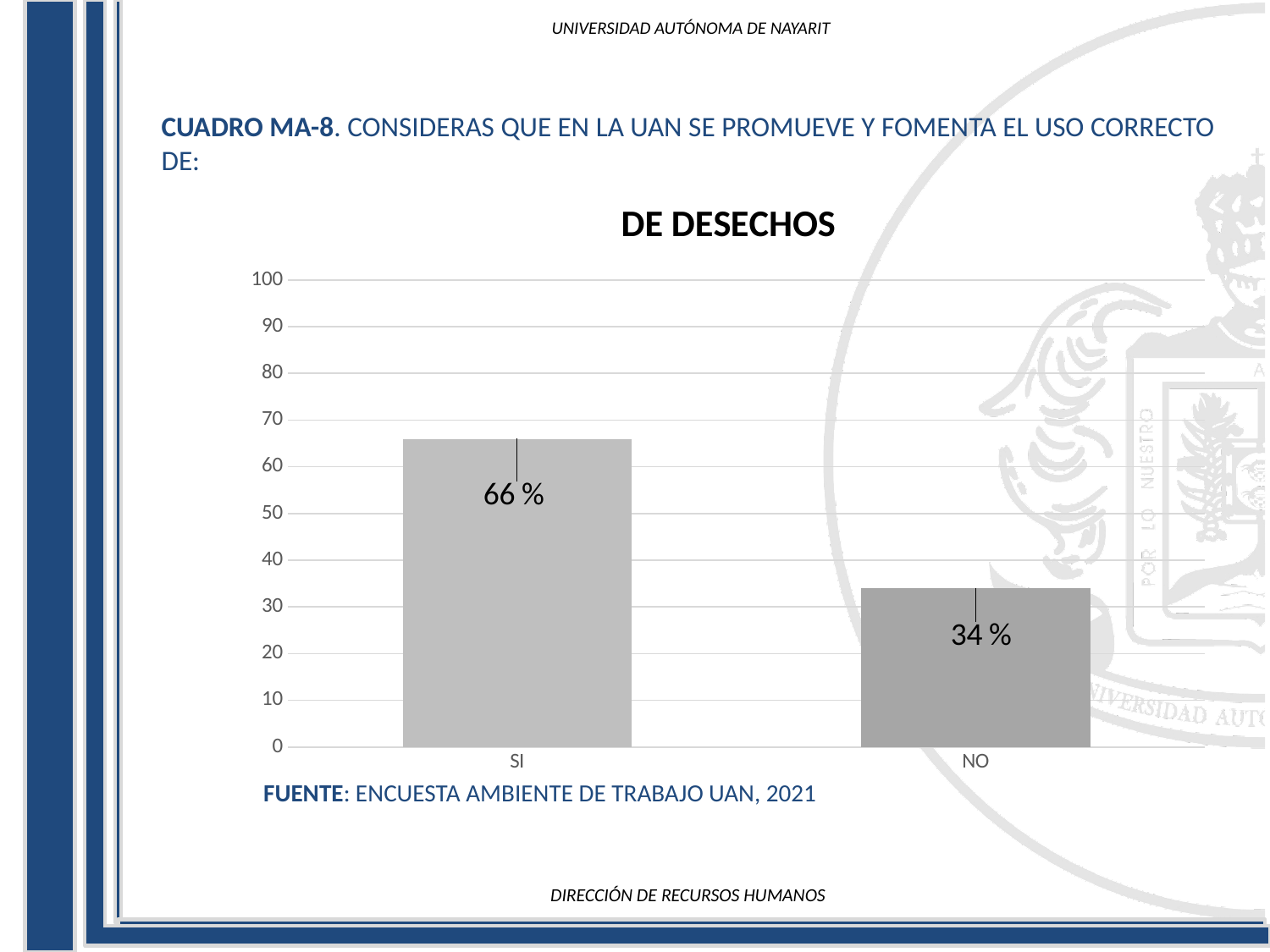
What is the value for SI? 66 % What is the title of the chart? DE DESECHOS How many categories are shown on the x axis? 2 Which is larger, the value for SI or the value for NO? SI Which category has the lowest value? NO What kind of chart is shown? bar chart What is the value for NO? 34 % What is the difference between the values for SI and NO? 32 % Is the value for SI greater or less than 60? greater Is the value for NO greater or less than 40? less Which category has the highest value? SI What is the maximum value shown on the y axis? 100